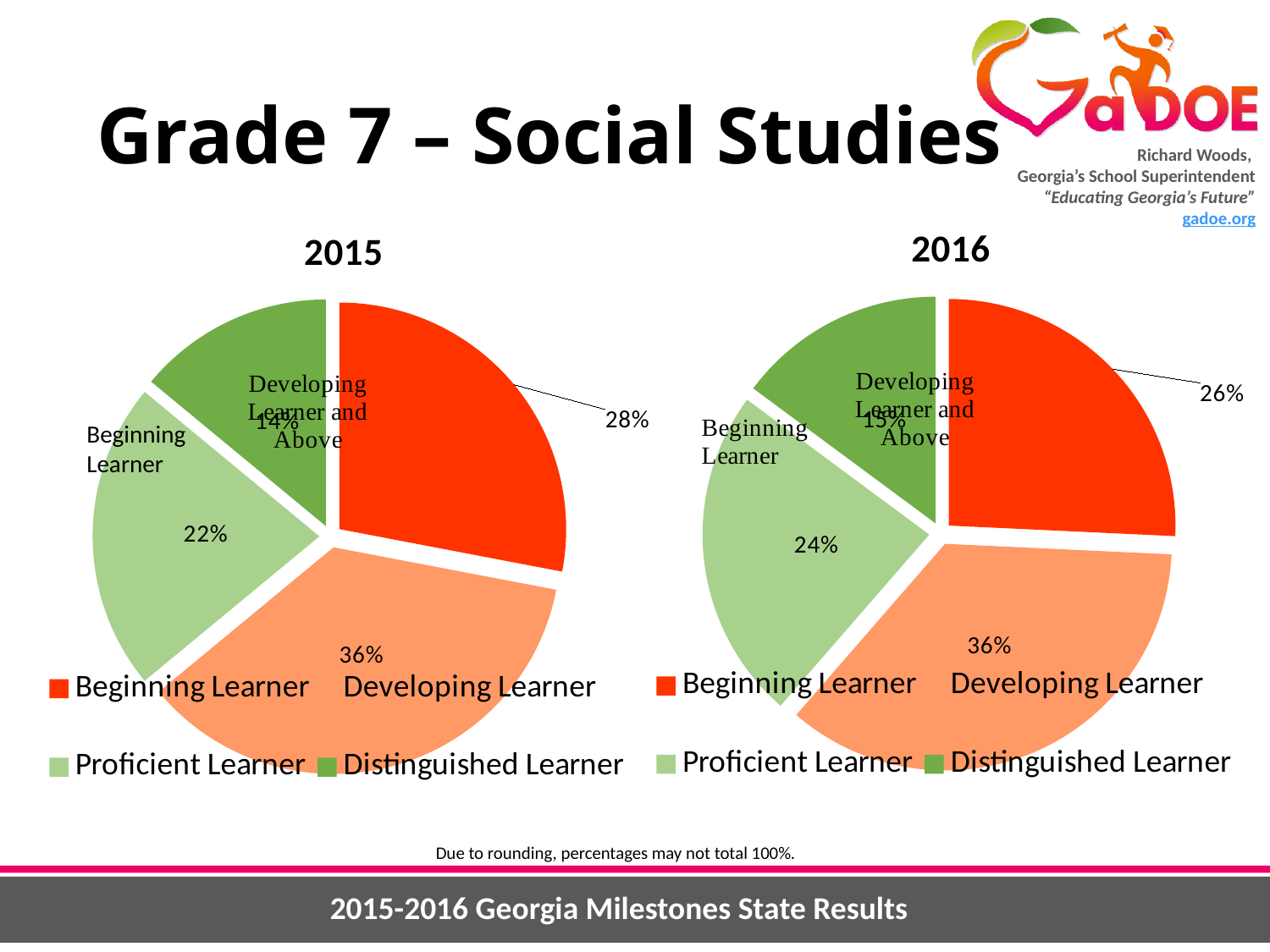
Which is larger: Proficient Learner in the 2015 pie chart or Proficient Learner in the 2016 pie chart? 2016 In the 2016 pie chart, what percentage is shown for Proficient Learner? 24% In the 2016 pie chart, what is the difference between the Developing Learner and Proficient Learner percentages? 12% In the 2016 pie chart, which category has the smallest share? Distinguished Learner How many categories does the 2015 pie chart show? 4 What is the difference between the Beginning Learner percentages in the 2015 and 2016 pie charts? 2% What kind of chart is used for the 2016 data? Pie chart In the 2015 pie chart, what percentage is shown for Developing Learner? 36% In the 2015 pie chart, what percentage is shown for Beginning Learner? 28% In the 2016 pie chart, what percentage is shown for Distinguished Learner? 15% In the 2015 pie chart, which category has the largest share? Developing Learner What is the title of the chart on the left? 2015